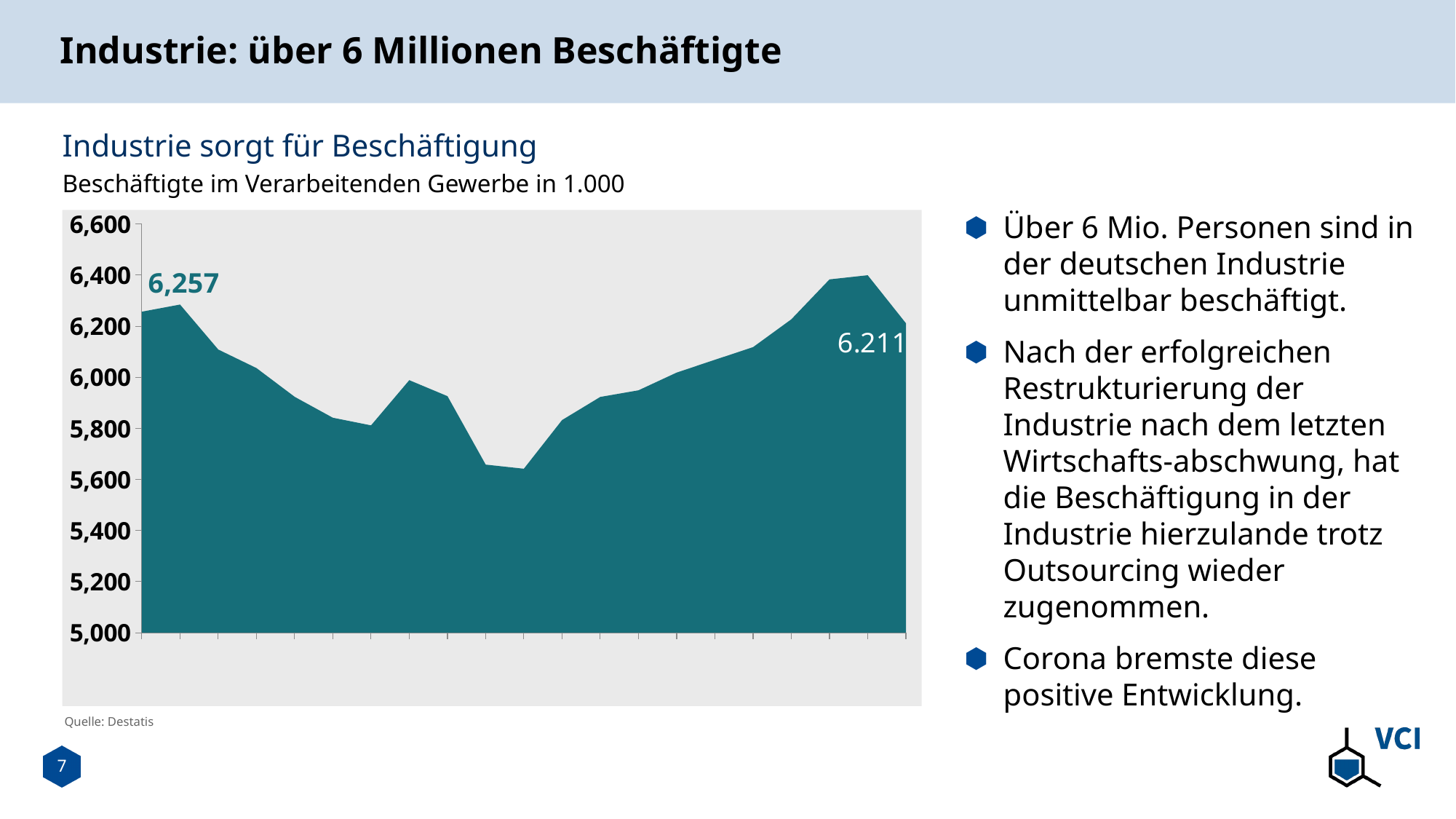
Is the starting value of the series greater or less than 6,000? greater Is the highest point of the series greater or less than 6,200? greater What is the subtitle describing the chart's data? Beschäftigte im Verarbeitenden Gewerbe in 1.000 Does the series rise or fall over its final segment, after the peak? fall What is the value labelled at the start of the series? 6,257 What is the value labelled at the end of the series? 6.211 Which is larger, the value at the start of the series (6,257) or the value at the end (6.211)? the start value, 6,257 What is the highest value shown on the y axis? 6,600 Is the lowest point of the series greater or less than 5,800? less Does the series rise or fall between its lowest point and its peak near the right end? rise What kind of chart is shown on the slide? area chart